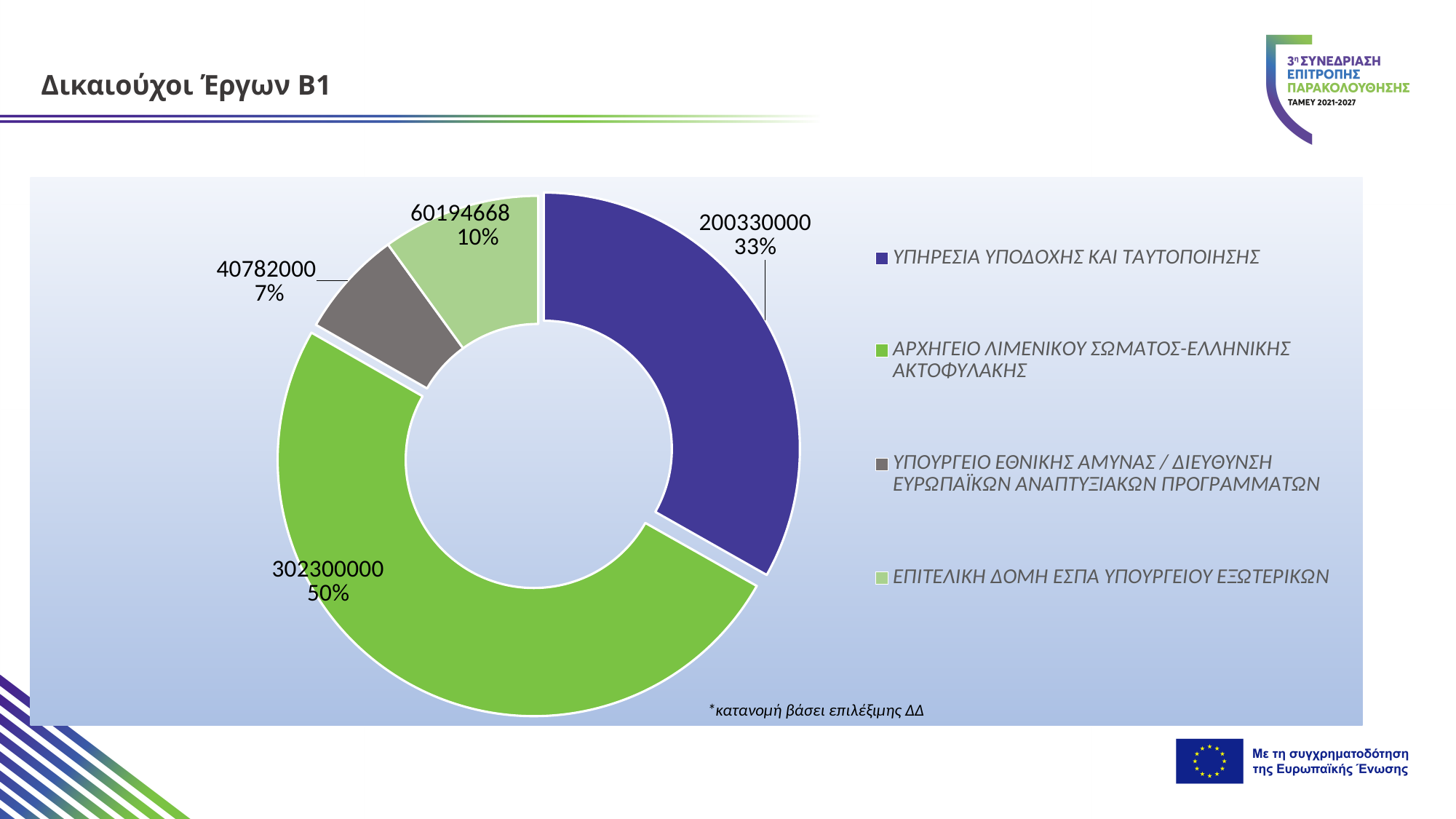
Which beneficiary has the smallest slice? ΥΠΟΥΡΓΕΙΟ ΕΘΝΙΚΗΣ ΑΜΥΝΑΣ / ΔΙΕΥΘΥΝΣΗ ΕΥΡΩΠΑΪΚΩΝ ΑΝΑΠΤΥΞΙΑΚΩΝ ΠΡΟΓΡΑΜΜΑΤΩΝ What percentage share does ΑΡΧΗΓΕΙΟ ΛΙΜΕΝΙΚΟΥ ΣΩΜΑΤΟΣ-ΕΛΛΗΝΙΚΗΣ ΑΚΤΟΦΥΛΑΚΗΣ have? 50% What percentage share does ΥΠΟΥΡΓΕΙΟ ΕΘΝΙΚΗΣ ΑΜΥΝΑΣ / ΔΙΕΥΘΥΝΣΗ ΕΥΡΩΠΑΪΚΩΝ ΑΝΑΠΤΥΞΙΑΚΩΝ ΠΡΟΓΡΑΜΜΑΤΩΝ have? 7% What value is shown for ΥΠΗΡΕΣΙΑ ΥΠΟΔΟΧΗΣ ΚΑΙ ΤΑΥΤΟΠΟΙΗΣΗΣ? 200330000 What value is shown for ΑΡΧΗΓΕΙΟ ΛΙΜΕΝΙΚΟΥ ΣΩΜΑΤΟΣ-ΕΛΛΗΝΙΚΗΣ ΑΚΤΟΦΥΛΑΚΗΣ? 302300000 What is the title of the slide containing the chart? Δικαιούχοι Έργων Β1 How many beneficiaries are shown in the chart? 4 What value is shown for ΕΠΙΤΕΛΙΚΗ ΔΟΜΗ ΕΣΠΑ ΥΠΟΥΡΓΕΙΟΥ ΕΞΩΤΕΡΙΚΩΝ? 60194668 What kind of chart is shown on the slide? Doughnut chart Which is larger, the value for ΕΠΙΤΕΛΙΚΗ ΔΟΜΗ ΕΣΠΑ ΥΠΟΥΡΓΕΙΟΥ ΕΞΩΤΕΡΙΚΩΝ or the value for ΥΠΟΥΡΓΕΙΟ ΕΘΝΙΚΗΣ ΑΜΥΝΑΣ / ΔΙΕΥΘΥΝΣΗ ΕΥΡΩΠΑΪΚΩΝ ΑΝΑΠΤΥΞΙΑΚΩΝ ΠΡΟΓΡΑΜΜΑΤΩΝ? ΕΠΙΤΕΛΙΚΗ ΔΟΜΗ ΕΣΠΑ ΥΠΟΥΡΓΕΙΟΥ ΕΞΩΤΕΡΙΚΩΝ Which beneficiary has the largest slice? ΑΡΧΗΓΕΙΟ ΛΙΜΕΝΙΚΟΥ ΣΩΜΑΤΟΣ-ΕΛΛΗΝΙΚΗΣ ΑΚΤΟΦΥΛΑΚΗΣ What is the difference between the values for ΑΡΧΗΓΕΙΟ ΛΙΜΕΝΙΚΟΥ ΣΩΜΑΤΟΣ-ΕΛΛΗΝΙΚΗΣ ΑΚΤΟΦΥΛΑΚΗΣ and ΥΠΗΡΕΣΙΑ ΥΠΟΔΟΧΗΣ ΚΑΙ ΤΑΥΤΟΠΟΙΗΣΗΣ? 101970000